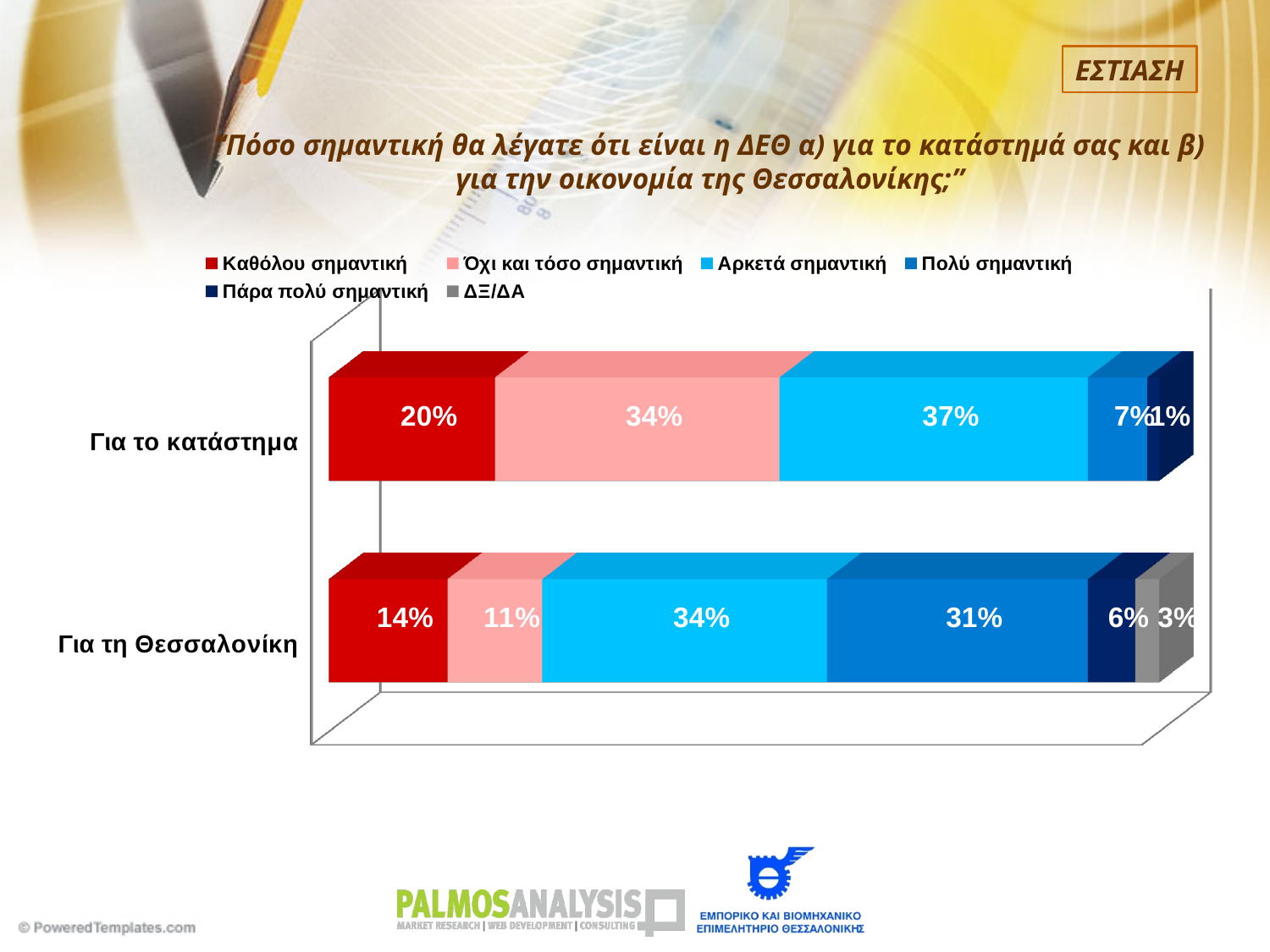
Which segment is the smallest in the 'Για τη Θεσσαλονίκη' bar? ΔΞ/ΔΑ What is the value for 'Όχι και τόσο σημαντική' in the 'Για το κατάστημα' bar? 34% What is the difference between 'Πολύ σημαντική' for 'Για τη Θεσσαλονίκη' and 'Πολύ σημαντική' for 'Για το κατάστημα'? 24% What is the value for 'Πολύ σημαντική' in the 'Για τη Θεσσαλονίκη' bar? 31% What is the value for 'ΔΞ/ΔΑ' in the 'Για τη Θεσσαλονίκη' bar? 3% What kind of chart is shown on the slide? stacked bar chart Which is larger: 'Καθόλου σημαντική' for 'Για το κατάστημα' or 'Καθόλου σημαντική' for 'Για τη Θεσσαλονίκη'? Για το κατάστημα Which segment is the largest in the 'Για το κατάστημα' bar? Αρκετά σημαντική How many categories (bars) are plotted in the chart? 2 How many series does the legend list? 6 What is the value for 'Αρκετά σημαντική' in the 'Για το κατάστημα' bar? 37% What is the value for 'Καθόλου σημαντική' in the 'Για τη Θεσσαλονίκη' bar? 14%